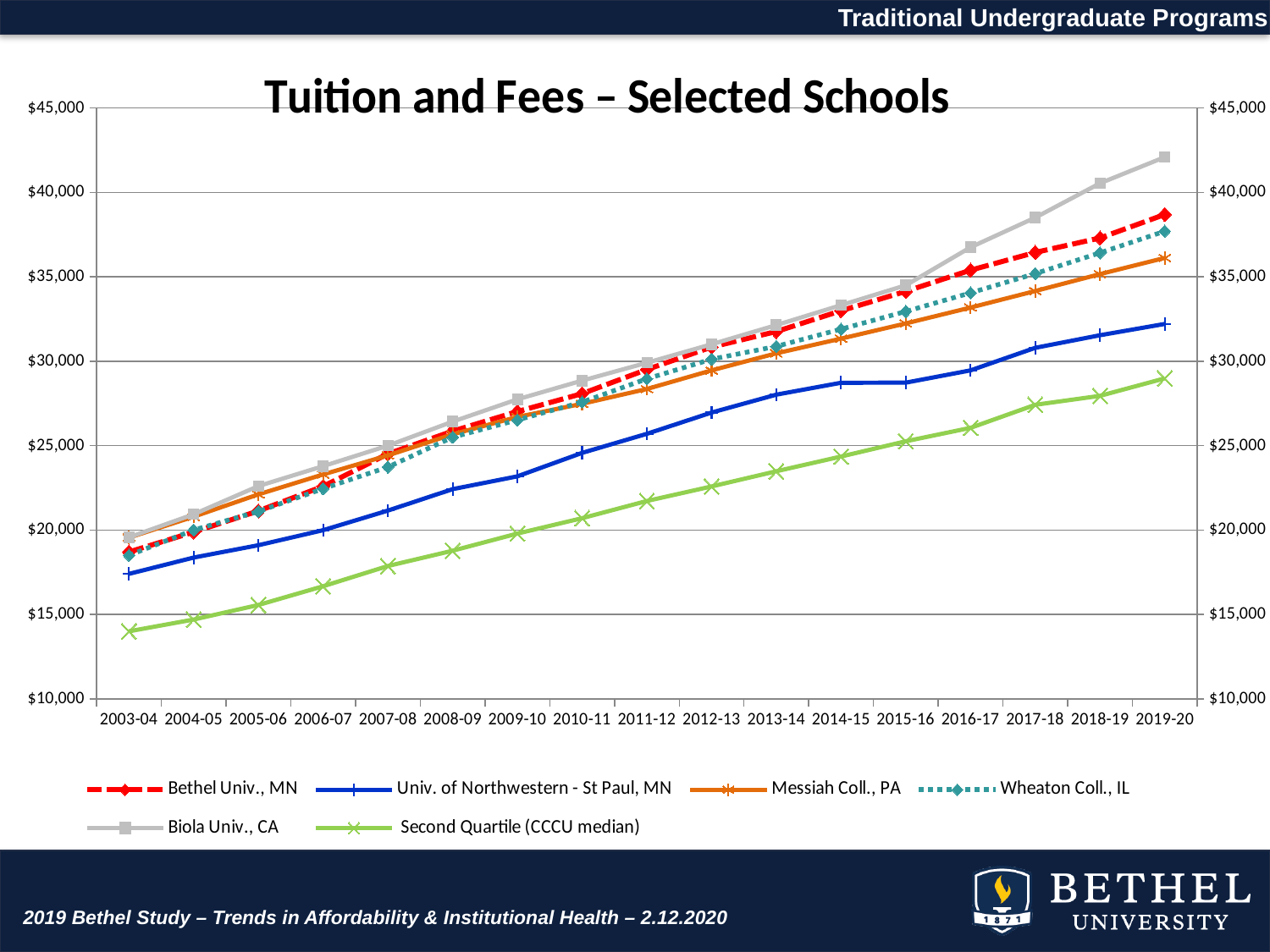
How many series does the legend list? 6 What is the title of the chart? Tuition and Fees – Selected Schools In 2019-20, which is higher: Bethel Univ., MN or Univ. of Northwestern - St Paul, MN? Bethel Univ., MN Which series is drawn as a red dashed line? Bethel Univ., MN How many academic years are shown along the x axis? 17 Which school has the highest tuition and fees in 2019-20? Biola Univ., CA Do the tuition and fees for Bethel Univ., MN rise or fall from 2003-04 to 2019-20? Rise What kind of chart is shown on the slide? Line chart Is the value for Second Quartile (CCCU median) in 2003-04 greater or less than $15,000? less Which series has the lowest value in 2019-20? Second Quartile (CCCU median) Is the value for Univ. of Northwestern - St Paul, MN in 2019-20 greater or less than $35,000? less Is the value for Biola Univ., CA in 2019-20 greater or less than $40,000? greater